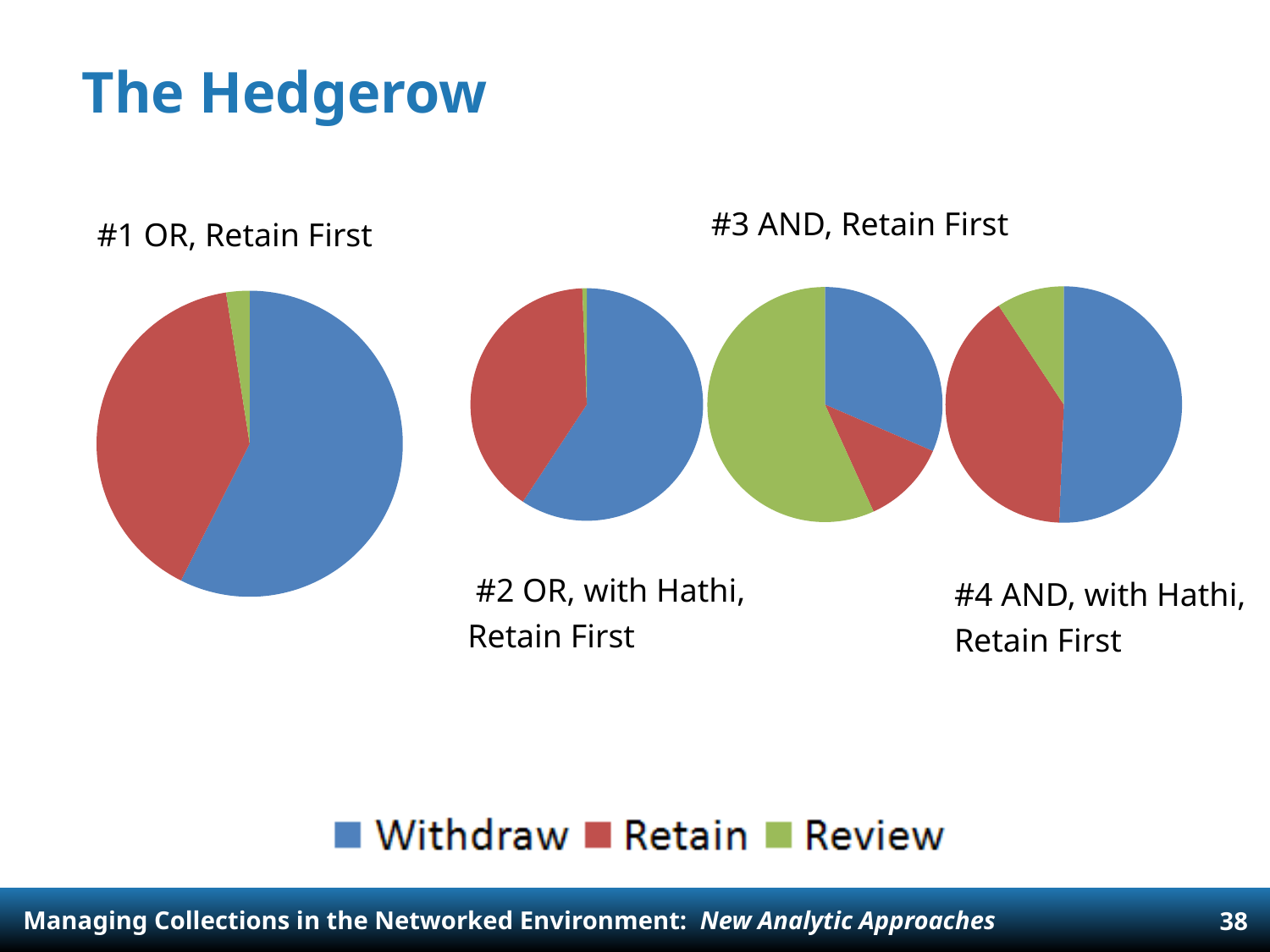
In the "#1 OR, Retain First" pie chart, which category has the smallest slice? Review In the "#1 OR, Retain First" pie chart, which category has the largest slice? Withdraw In the "#3 AND, Retain First" pie chart, which is larger, the Withdraw slice or the Retain slice? Withdraw How many categories does the legend list for the pie charts? 3 In the "#4 AND, with Hathi, Retain First" pie chart, which is larger, the Retain slice or the Review slice? Retain In the "#3 AND, Retain First" pie chart, which category has the smallest slice? Retain What kind of chart is used for "#1 OR, Retain First"? Pie chart In the "#2 OR, with Hathi, Retain First" pie chart, which category has the largest slice? Withdraw In the "#2 OR, with Hathi, Retain First" pie chart, which category has the smallest slice? Review In the "#3 AND, Retain First" pie chart, which category has the largest slice? Review Which colour represents Review in the pie charts? Green How many pie charts are shown on the slide? 4